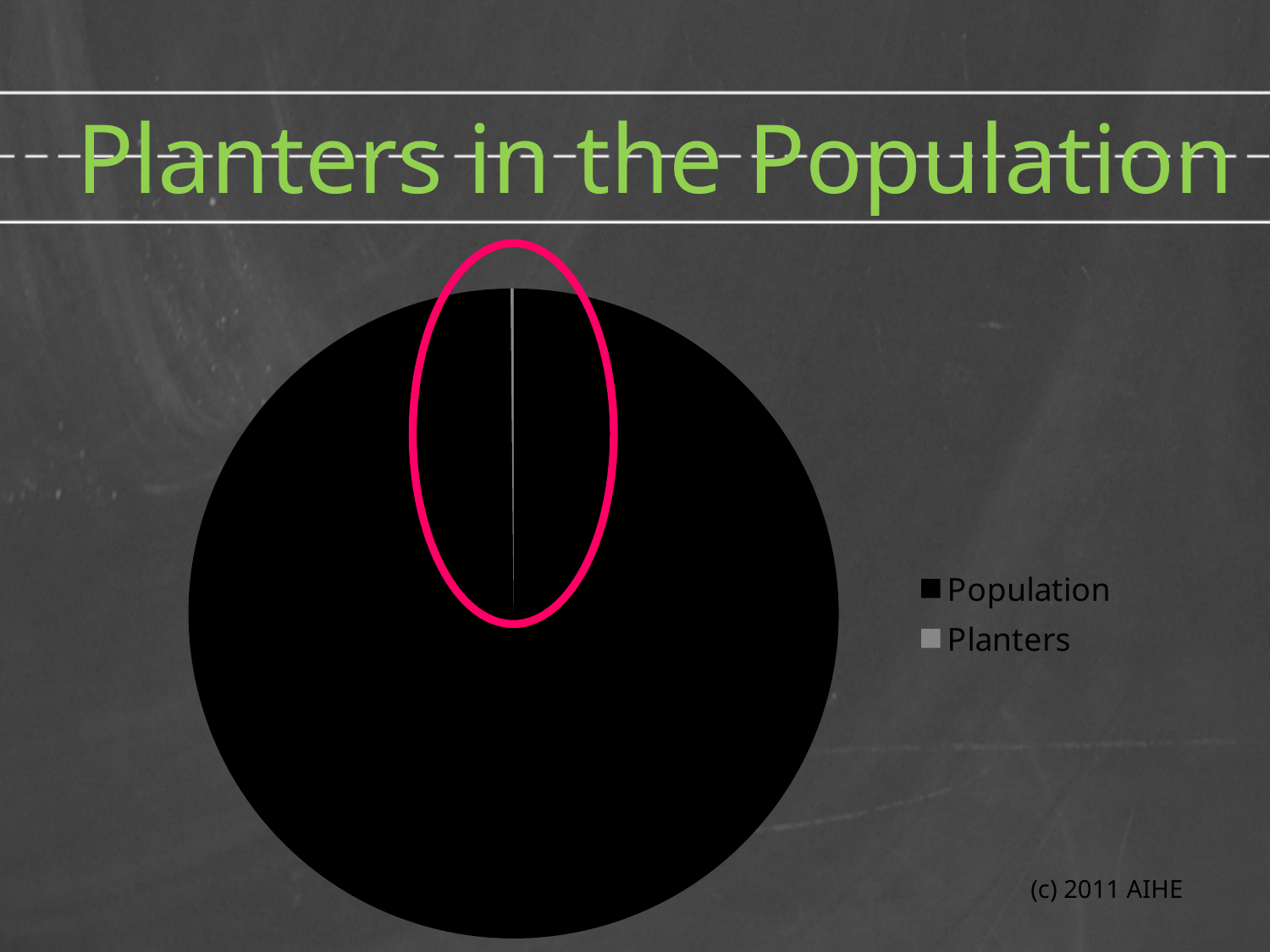
What kind of chart is shown on the slide? pie chart Which category takes up the largest share of the pie? Population What is the title of the chart? Planters in the Population Which is larger in the pie chart, Population or Planters? Population How many entries does the legend list? 2 What colour is the Population slice in the pie chart? black Which category takes up the smallest share of the pie? Planters How many slices does the pie chart have? 2